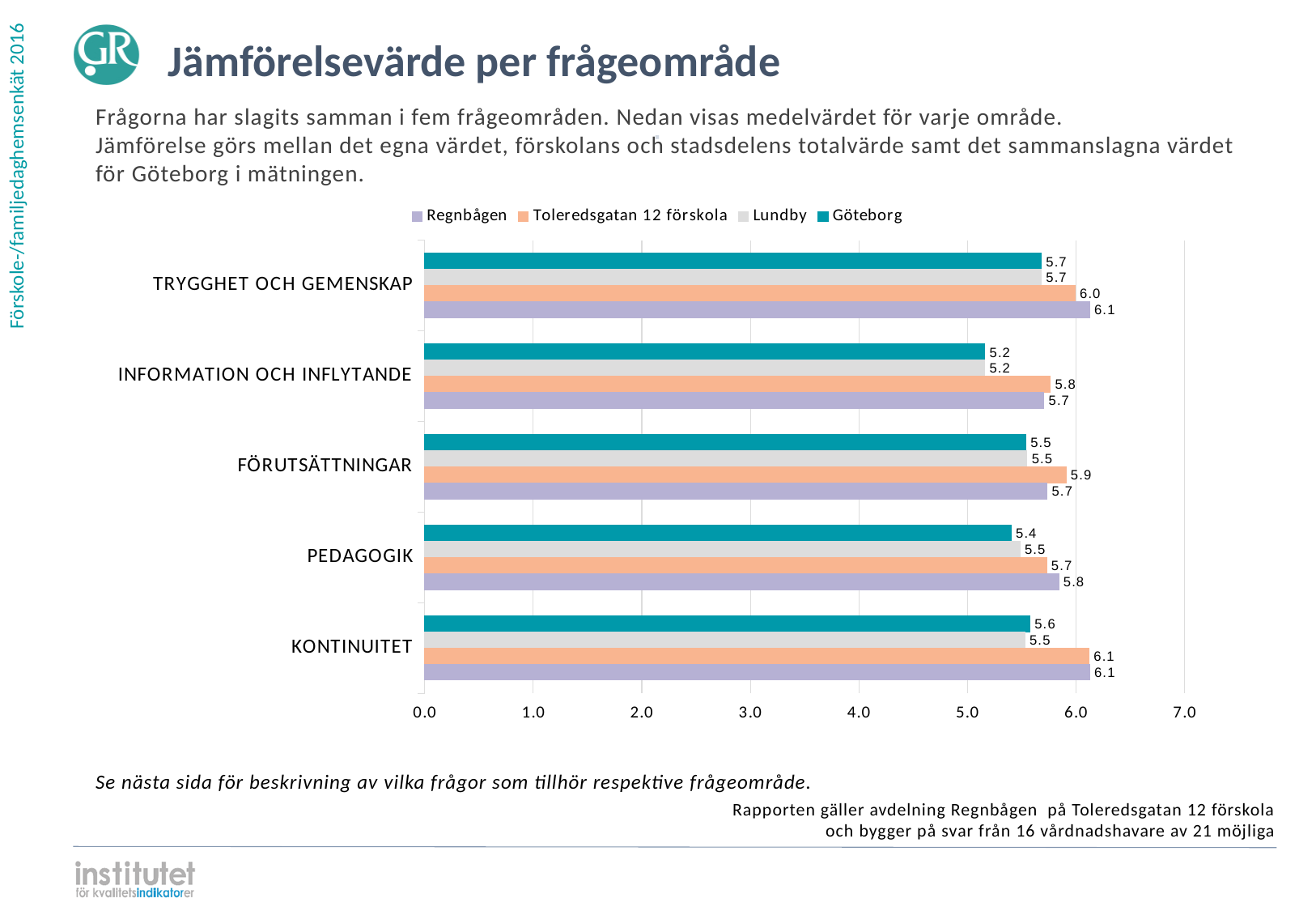
In the INFORMATION OCH INFLYTANDE category, which is larger: the value for Toleredsgatan 12 förskola or the value for Regnbågen? Toleredsgatan 12 förskola What is the title of the slide? Jämförelsevärde per frågeområde How many categories are shown on the chart? 5 What is the value for Lundby in the PEDAGOGIK category? 5.5 What is the value for Göteborg in the INFORMATION OCH INFLYTANDE category? 5.2 In which category does Göteborg have its lowest value? INFORMATION OCH INFLYTANDE What is the value for Toleredsgatan 12 förskola in the FÖRUTSÄTTNINGAR category? 5.9 What kind of chart is shown on the slide? Bar chart What is the difference between the Regnbågen value and the Göteborg value in the PEDAGOGIK category? 0.4 How many series does the legend list? 4 In which category does Toleredsgatan 12 förskola have its highest value? KONTINUITET What is the value for Regnbågen in the TRYGGHET OCH GEMENSKAP category? 6.1